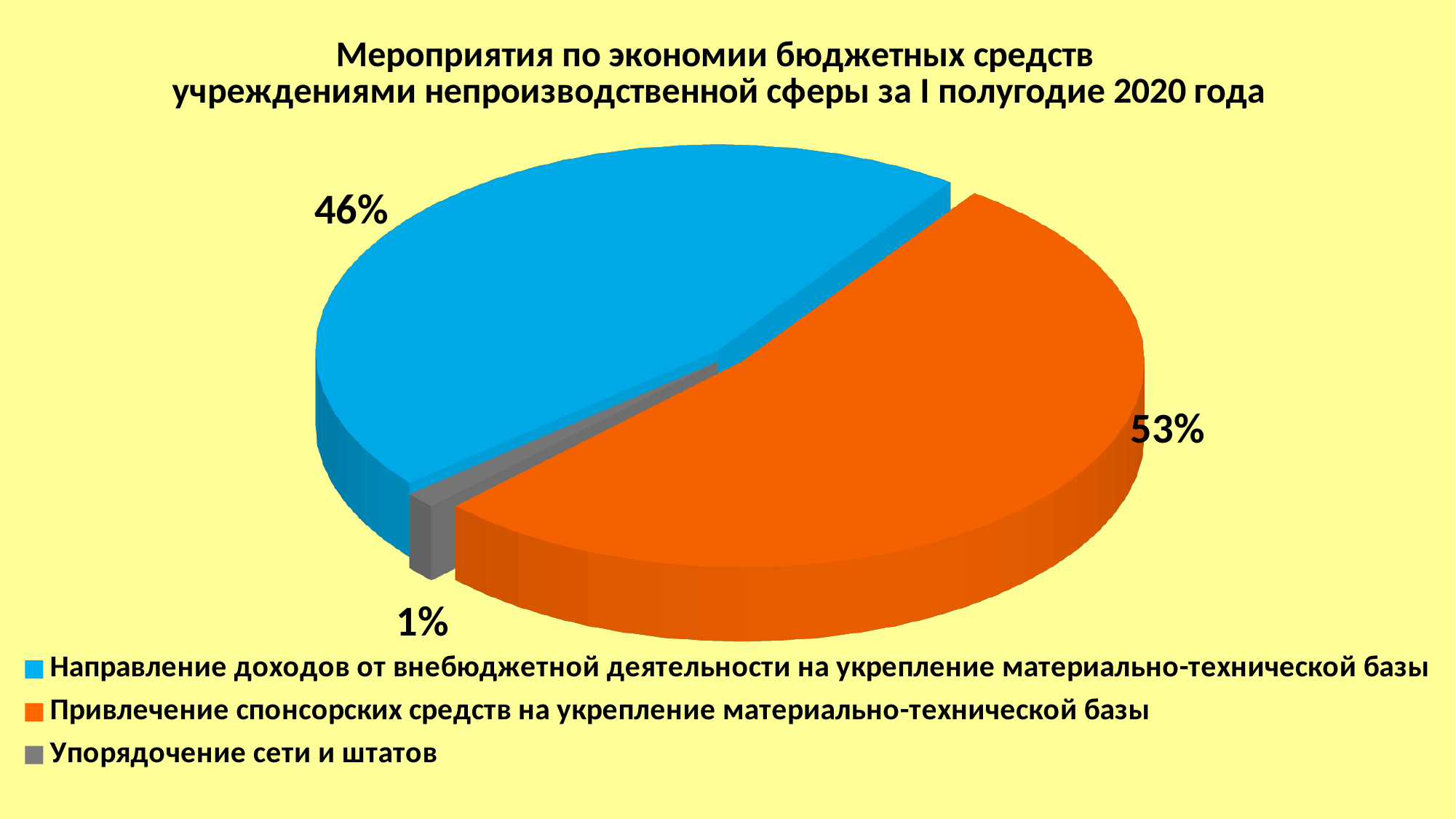
What share of the pie does "Привлечение спонсорских средств на укрепление материально-технической базы" represent? 53% Which category has the smallest share of the pie? Упорядочение сети и штатов Which is larger: the share for "Направление доходов от внебюджетной деятельности" or the share for "Упорядочение сети и штатов"? Направление доходов от внебюджетной деятельности на укрепление материально-технической базы What is the difference in percentage points between the share for "Привлечение спонсорских средств" and the share for "Направление доходов от внебюджетной деятельности"? 7 What colour is the slice for "Упорядочение сети и штатов"? Grey What is the title of the chart? Мероприятия по экономии бюджетных средств учреждениями непроизводственной сферы за I полугодие 2020 года Which category has the largest share of the pie? Привлечение спонсорских средств на укрепление материально-технической базы What share of the pie does "Направление доходов от внебюджетной деятельности на укрепление материально-технической базы" represent? 46% What share of the pie does "Упорядочение сети и штатов" represent? 1% What kind of chart is shown on the slide? Pie chart How many slices does the pie chart have? 3 How many entries does the legend list? 3